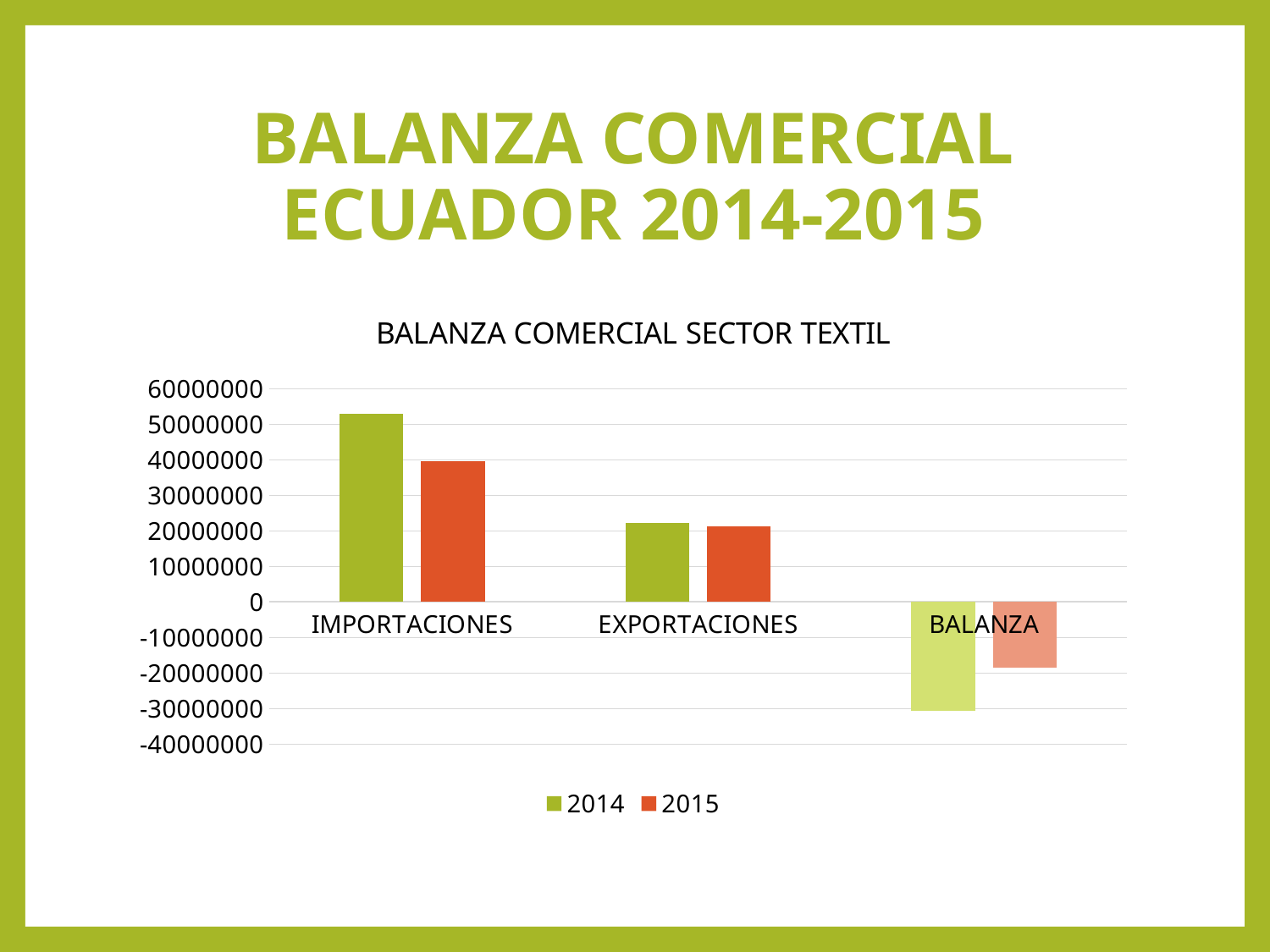
How many series does the legend list? 2 Is the 2015 value for IMPORTACIONES greater or less than 50000000? less Is the 2014 value for BALANZA greater or less than -20000000? less Which is larger for IMPORTACIONES, the 2014 value or the 2015 value? 2014 Which is larger for BALANZA, the 2014 value or the 2015 value? 2015 What is the title of the chart? BALANZA COMERCIAL SECTOR TEXTIL How many categories are shown on the x axis? 3 Which category has the highest value for 2014? IMPORTACIONES Is the 2014 value for IMPORTACIONES greater or less than 50000000? greater Which category has the lowest value for 2015? BALANZA Which series is shown in orange in the legend? 2015 What kind of chart is shown on the slide? Bar chart